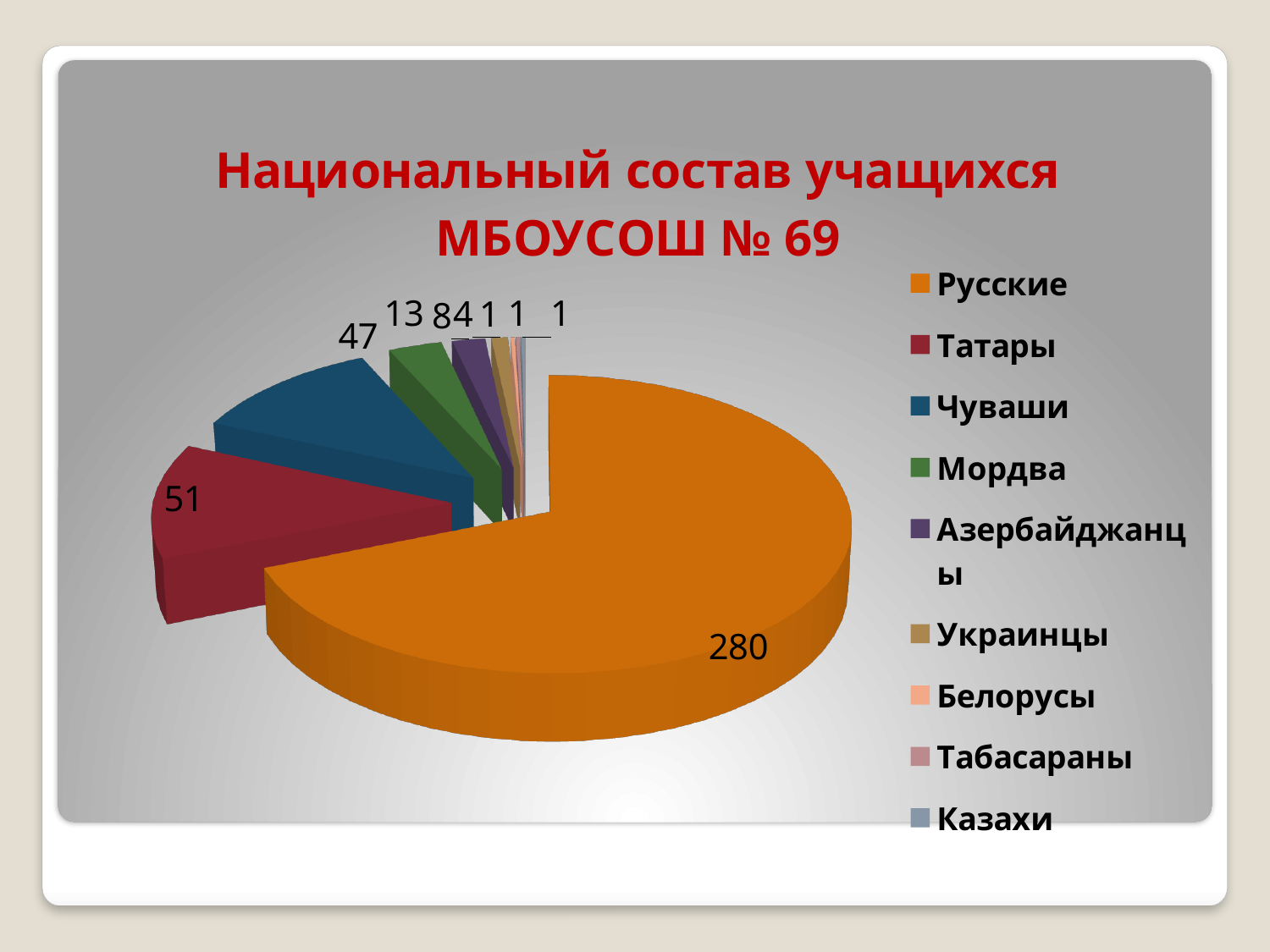
Which category has the largest slice of the pie? Русские What is the value for Мордва? 13 What is the title of the chart? Национальный состав учащихся МБОУСОШ № 69 What is the difference between the values for Русские and Татары? 229 How many categories does the legend list? 9 What colour is the slice for Русские? Orange What is the difference between the values for Татары and Чуваши? 4 Which is larger, the value for Чуваши or the value for Мордва? Чуваши What type of chart is shown on the slide? Pie chart What is the value for Русские? 280 What is the value for Татары? 51 What is the value for Чуваши? 47